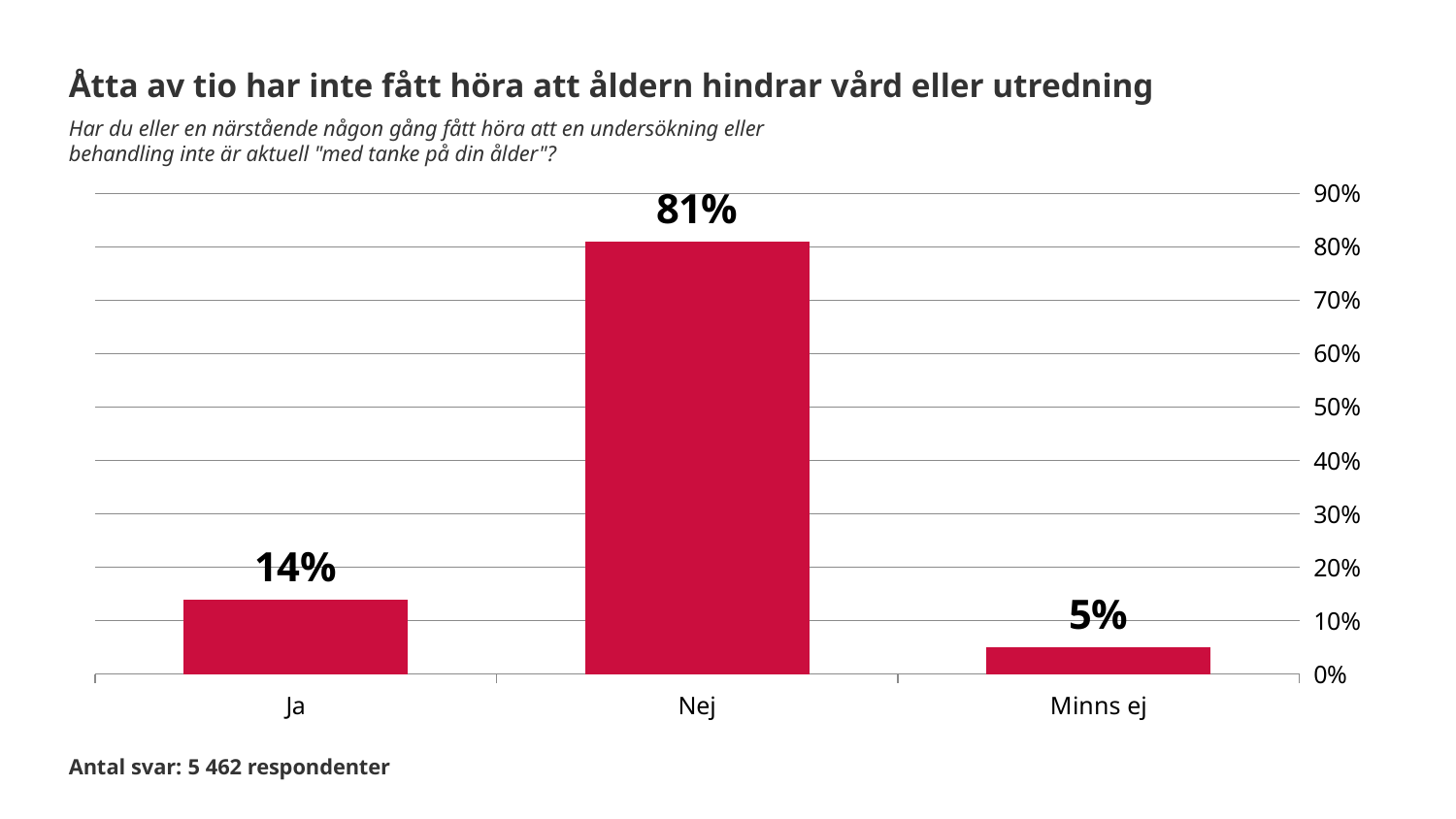
How many categories are shown on the x axis? 3 What is the value for "Nej"? 81% What kind of chart is shown on the slide? bar chart What is the value for "Minns ej"? 5% What is the difference between the values for "Ja" and "Minns ej"? 9% What is the value for "Ja"? 14% Is the value for "Nej" greater or less than 80%? greater Which is larger, the value for "Ja" or the value for "Minns ej"? Ja Which category has the lowest value? Minns ej Which category has the highest value? Nej What is the title of the slide? Åtta av tio har inte fått höra att åldern hindrar vård eller utredning What is the difference between the values for "Nej" and "Ja"? 67%